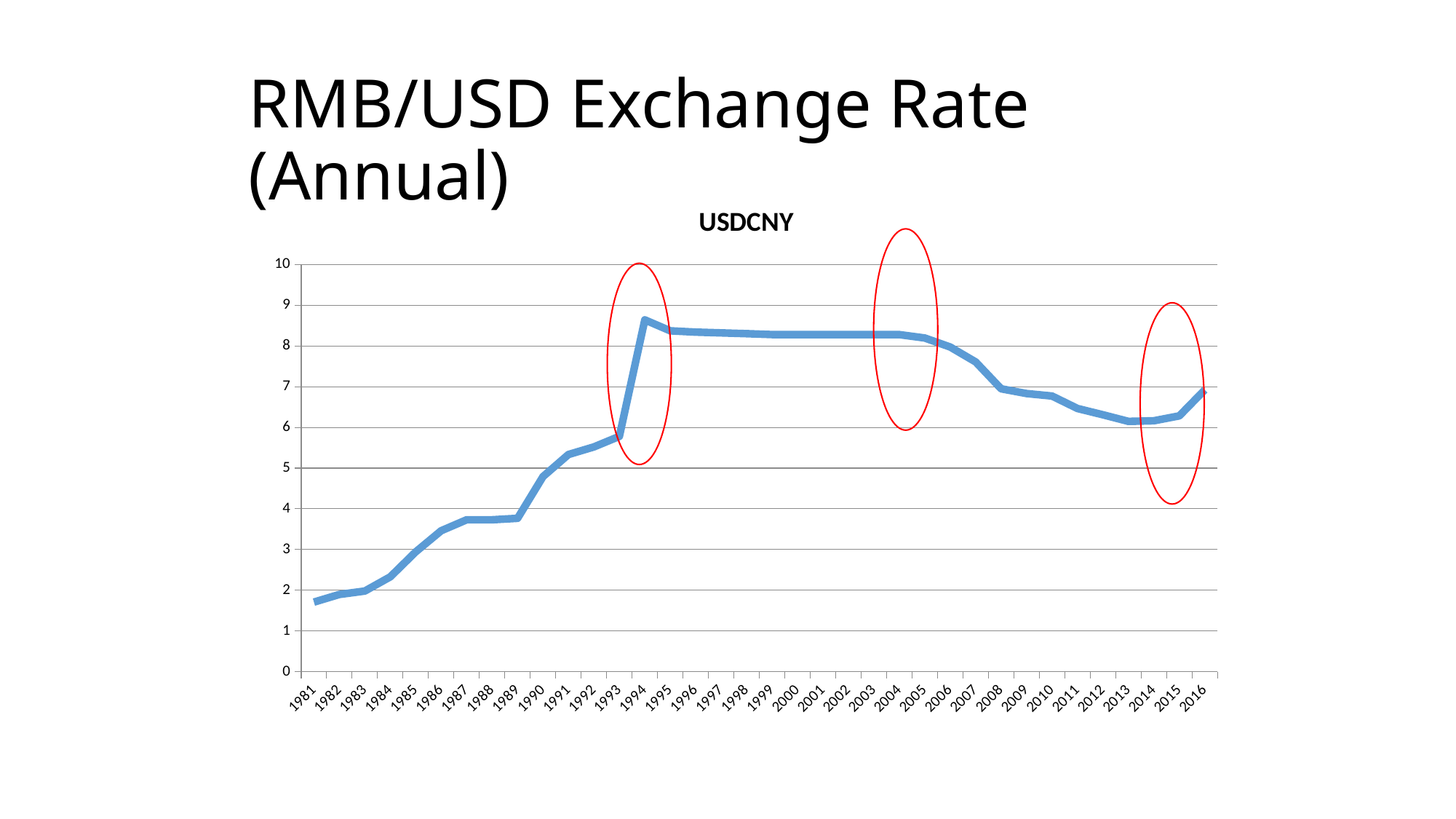
In which year is the USDCNY value lowest? 1981 Is the value for 1987 greater or less than 4? less Is the value for 1981 greater or less than 2? less Which year has the larger value, 1981 or 1990? 1990 Does the value rise or fall from 2005 to 2013? Fall Which year has the larger value, 2005 or 2013? 2005 In which year is the USDCNY value highest? 1994 Is the value for 1994 greater or less than 8? greater How many years are plotted along the x axis? 36 What is the title of the chart? USDCNY What kind of chart is shown on the slide? Line chart